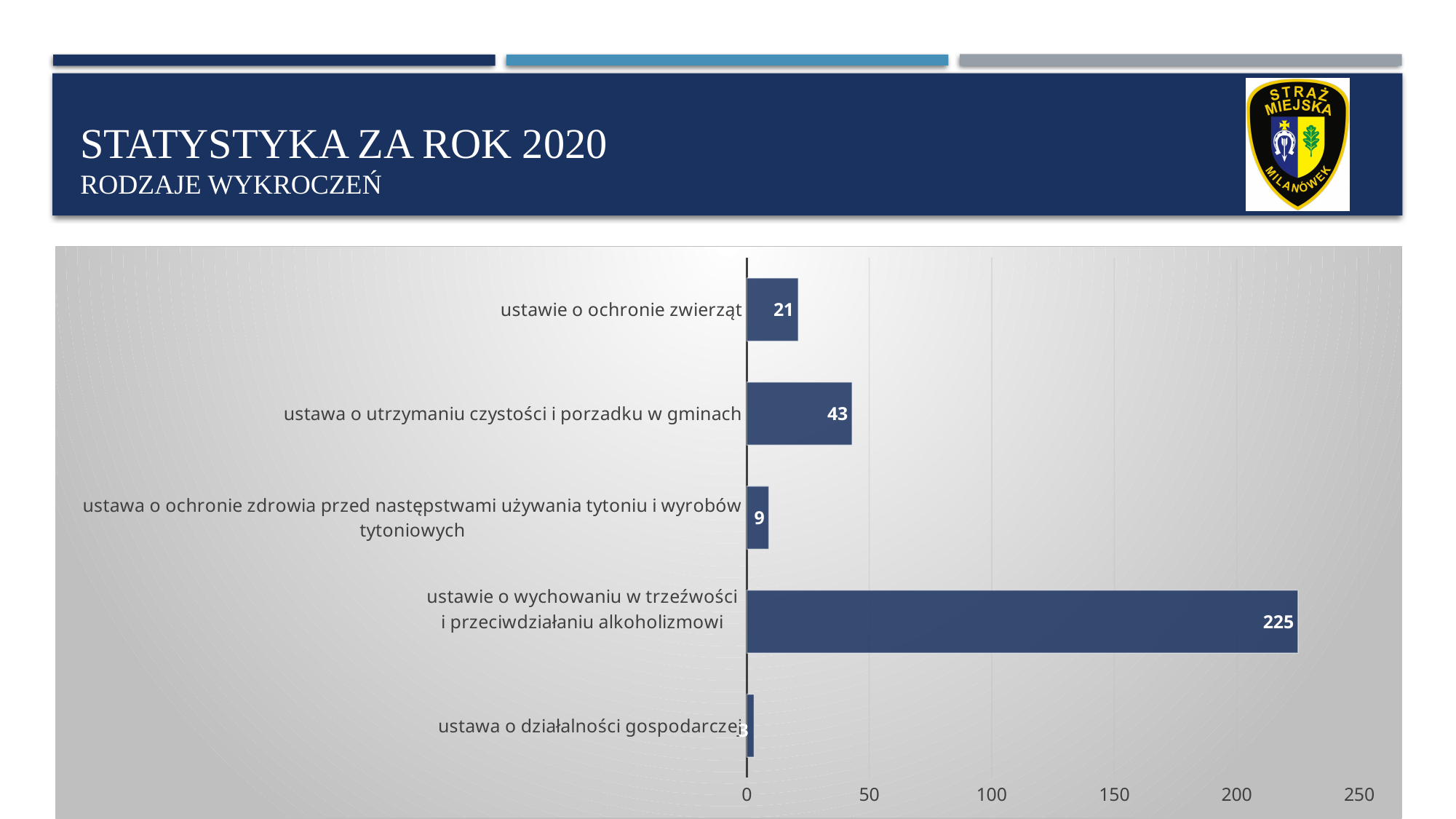
What is the value for "ustawa o ochronie zdrowia przed następstwami używania tytoniu i wyrobów tytoniowych"? 9 What is the value for "ustawie o wychowaniu w trzeźwości i przeciwdziałaniu alkoholizmowi"? 225 Which is larger: the value for "ustawie o ochronie zwierząt" or the value for "ustawa o ochronie zdrowia przed następstwami używania tytoniu i wyrobów tytoniowych"? ustawie o ochronie zwierząt Is the value for "ustawa o działalności gospodarczej" greater or less than 50? less What is the value for "ustawa o utrzymaniu czystości i porzadku w gminach"? 43 What is the title of the slide? STATYSTYKA ZA ROK 2020 What is the difference between the values for "ustawa o utrzymaniu czystości i porzadku w gminach" and "ustawie o ochronie zwierząt"? 22 What is the value for "ustawie o ochronie zwierząt"? 21 Which category has the lowest value? ustawa o działalności gospodarczej What type of chart is shown on the slide? bar chart How many categories are shown in the chart? 5 Which category has the highest value? ustawie o wychowaniu w trzeźwości i przeciwdziałaniu alkoholizmowi